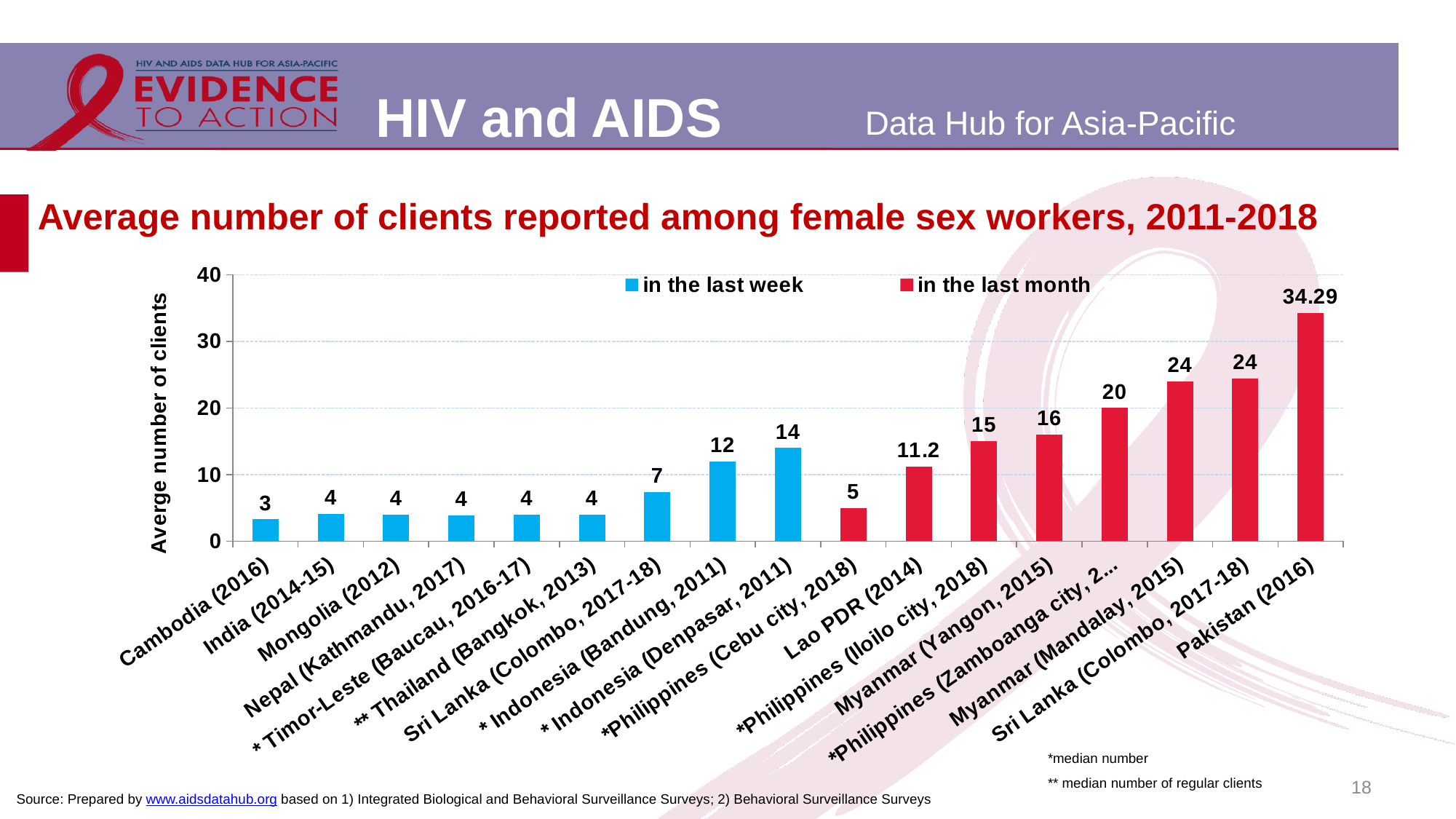
Which category has the highest value? Pakistan (2016) How many series does the legend list? 2 How many categories are shown on the x axis? 17 Which series is shown in red? in the last month What is the value for Lao PDR (2014)? 11.2 What is the difference between the values for Pakistan (2016) and Myanmar (Mandalay, 2015)? 10.29 What is the value for Pakistan (2016)? 34.29 What is the value for Myanmar (Yangon, 2015)? 16 What is the value for Indonesia (Denpasar, 2011)? 14 Which is larger, the value for Indonesia (Bandung, 2011) or the value for Philippines (Iloilo city, 2018)? Philippines (Iloilo city, 2018) What kind of chart is shown? Bar chart Which category has the lowest value? Cambodia (2016)